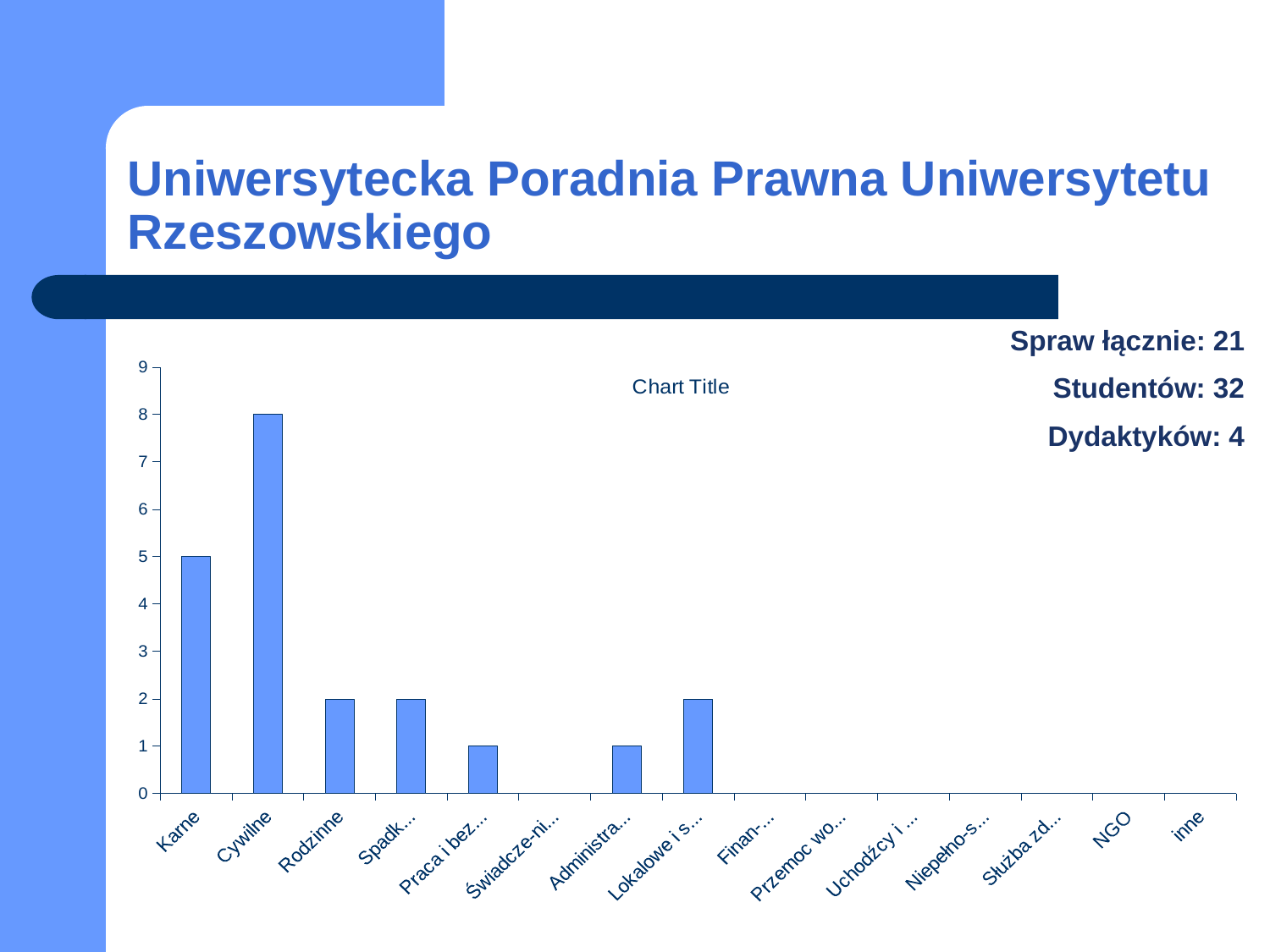
What is the difference between the values for Cywilne and Karne? 3 What is the value for NGO? 0 What is the value for Karne? 5 Is the value for Karne greater or less than 4? greater Which is larger, the value for Karne or the value for Rodzinne? Karne What is the title shown on the chart? Chart Title Which category has the highest value? Cywilne What is the value for Cywilne? 8 What is the value for Rodzinne? 2 What is the difference between the values for Karne and Rodzinne? 3 How many categories are shown on the x axis? 15 What kind of chart is shown on the slide? bar chart